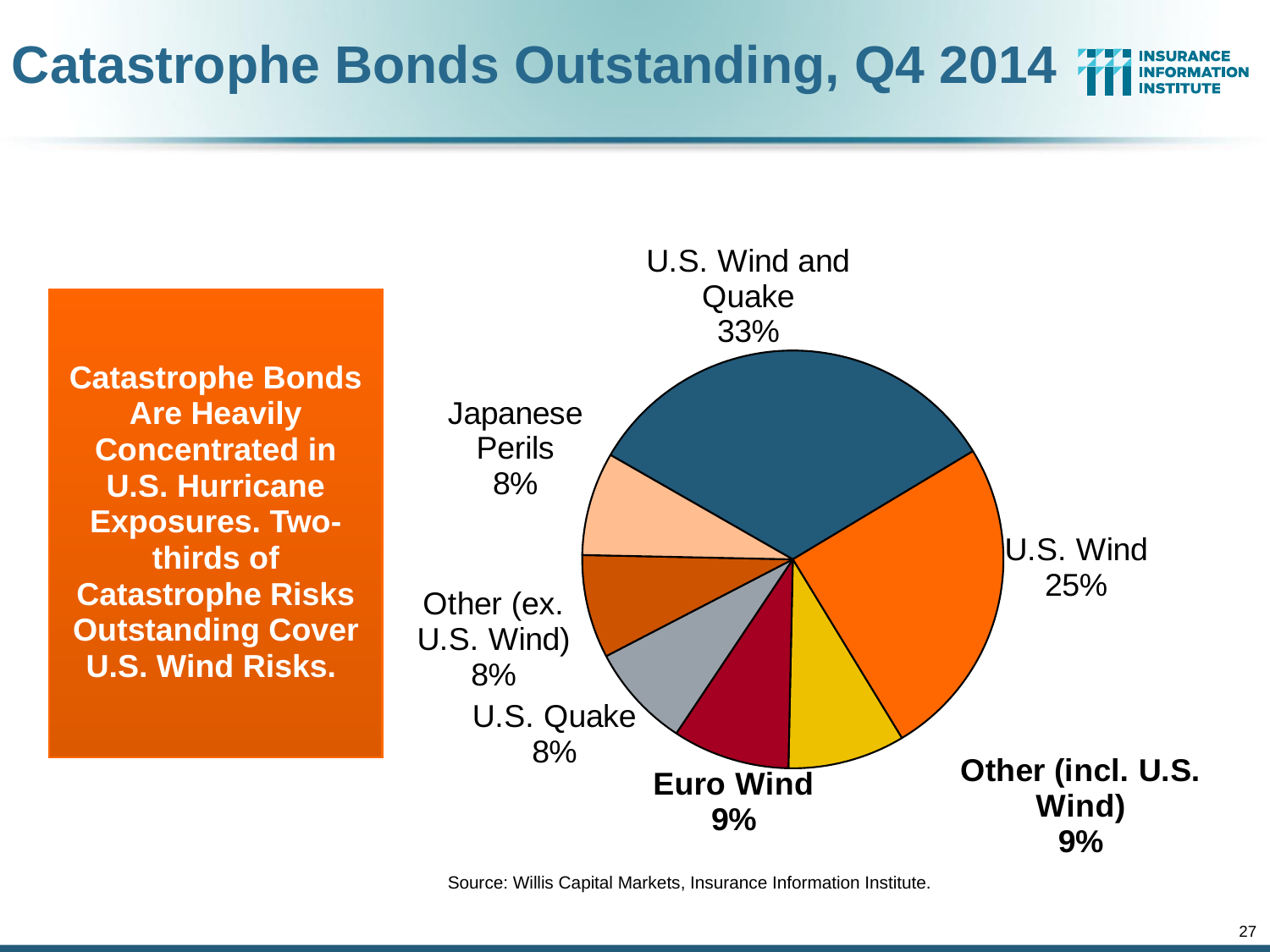
What is the title of the slide containing the pie chart? Catastrophe Bonds Outstanding, Q4 2014 What percentage of the pie is U.S. Wind? 25% What kind of chart is shown on the slide? Pie chart How many slices does the pie chart have? 7 What share of catastrophe bonds outstanding is U.S. Wind and Quake? 33% Which is larger, the U.S. Wind slice or the U.S. Quake slice? U.S. Wind What percentage is shown for Other (incl. U.S. Wind)? 9% What is the combined share of U.S. Wind and Quake and U.S. Wind? 58% What is the difference in percentage points between U.S. Wind and Quake and U.S. Wind? 8 What is the share for Japanese Perils? 8% What share does Euro Wind represent? 9% Which category has the largest slice of the pie? U.S. Wind and Quake